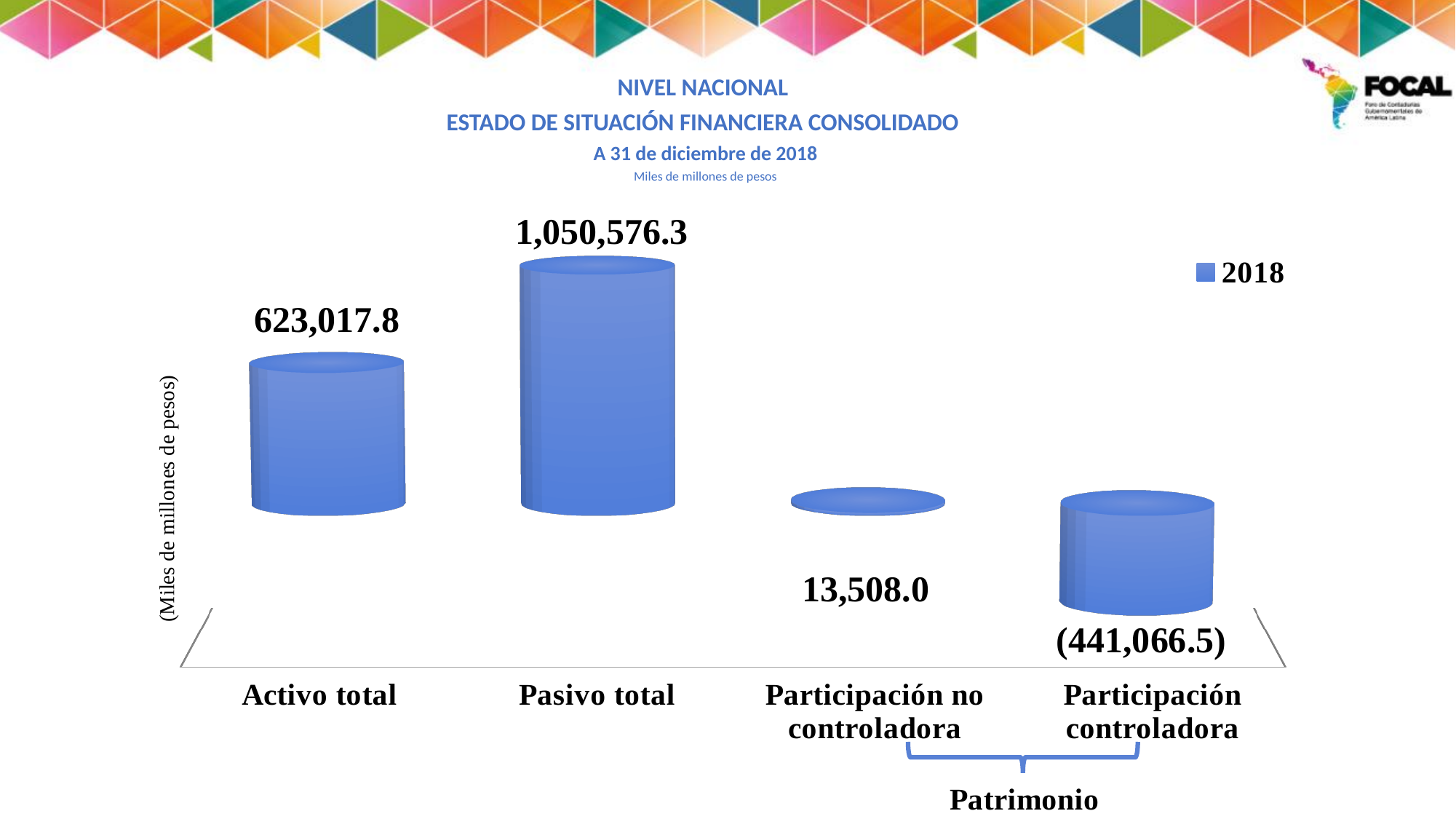
What is the value for Participación controladora? (441,066.5) Which category has the lowest value? Participación controladora What is the value for Participación no controladora? 13,508.0 How many categories are shown on the x axis? 4 What is the difference between Pasivo total and Activo total? 427,558.5 Which category has the highest value? Pasivo total What is the value for Activo total? 623,017.8 What kind of chart is shown on the slide? Bar chart Which is larger, Activo total or Pasivo total? Pasivo total What is the value for Pasivo total? 1,050,576.3 What year does the legend entry show? 2018 How many series does the legend list? 1